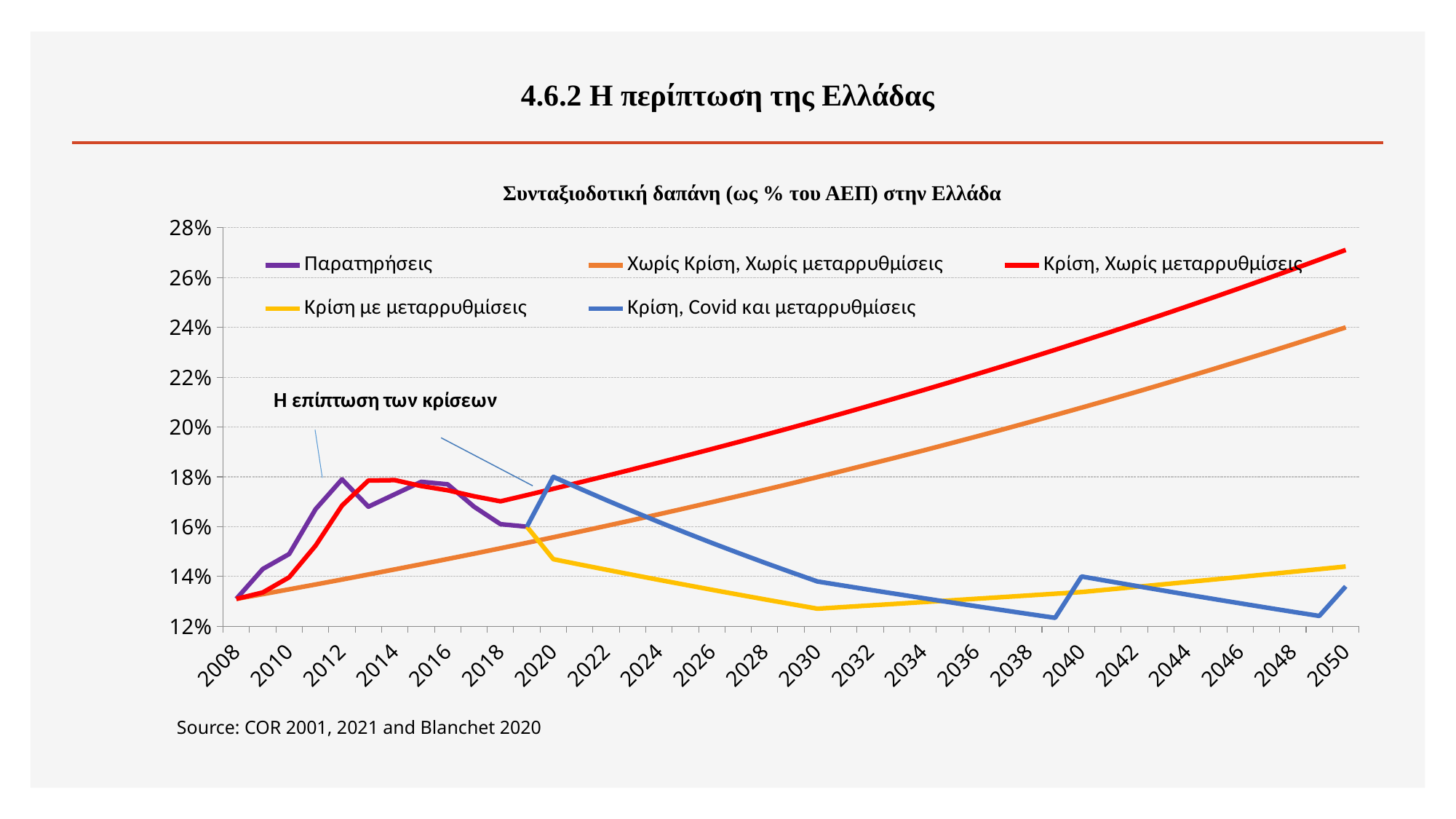
Which series has the highest value in 2050? Κρίση, Χωρίς μεταρρυθμίσεις Which series has the lowest value in 2050? Κρίση, Covid και μεταρρυθμίσεις What colour is the line for the series 'Κρίση, Covid και μεταρρυθμίσεις'? blue Is the value of the 'Χωρίς Κρίση, Χωρίς μεταρρυθμίσεις' series in 2020 greater or less than 16%? less How many year labels are shown on the x axis? 22 What kind of chart is shown on the slide? line chart Is the value of the 'Κρίση με μεταρρυθμίσεις' series in 2030 greater or less than 14%? less Does the 'Κρίση, Χωρίς μεταρρυθμίσεις' series rise or fall between 2020 and 2050? rise In 2050, which series is higher: 'Κρίση, Χωρίς μεταρρυθμίσεις' or 'Χωρίς Κρίση, Χωρίς μεταρρυθμίσεις'? Κρίση, Χωρίς μεταρρυθμίσεις How many series does the legend list? 5 What is the title of the chart? Συνταξιοδοτική δαπάνη (ως % του ΑΕΠ) στην Ελλάδα Is the value of the 'Κρίση, Χωρίς μεταρρυθμίσεις' series in 2050 greater or less than 26%? greater